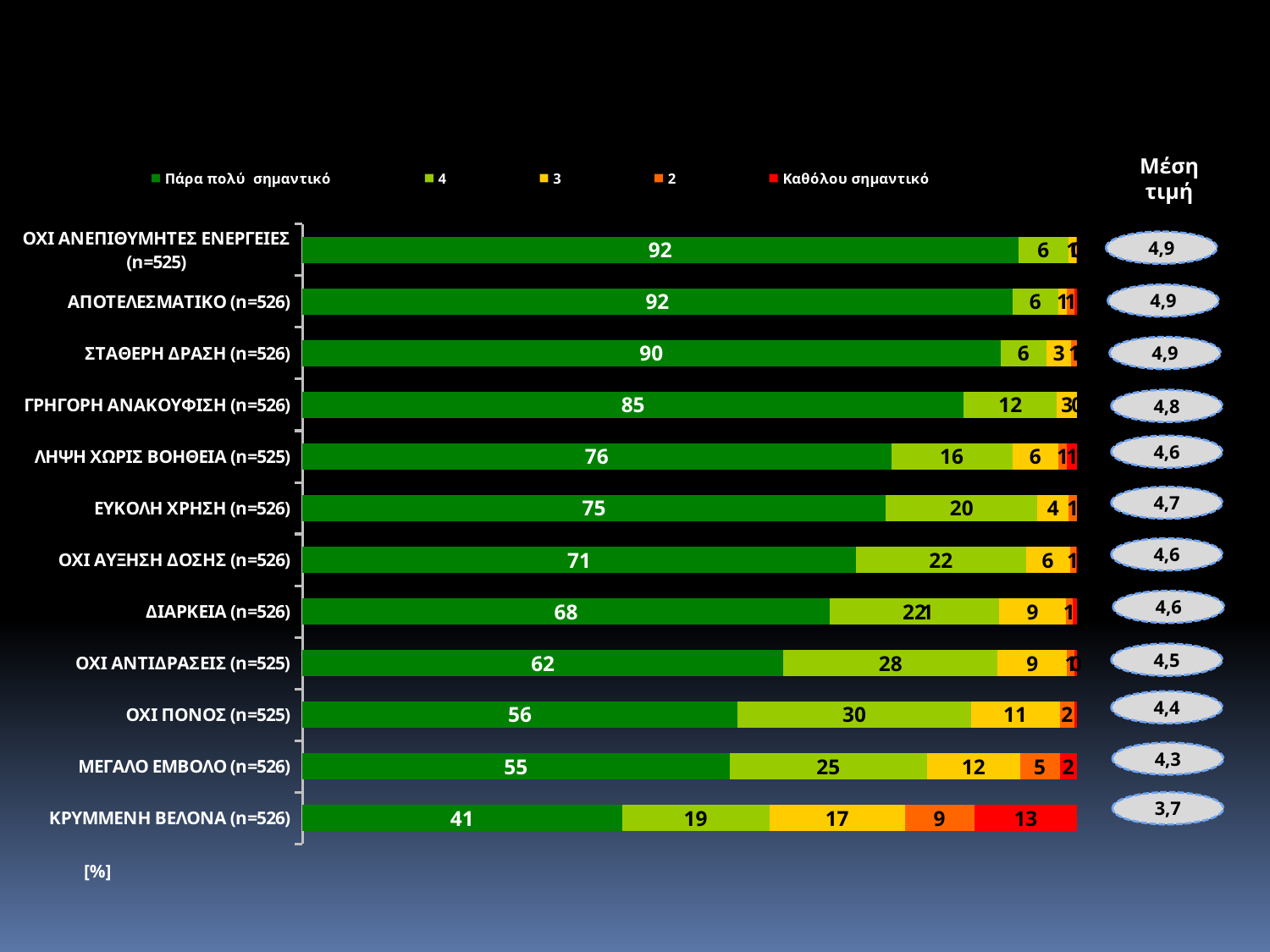
What is the value of 'Πάρα πολύ σημαντικό' for ΓΡΗΓΟΡΗ ΑΝΑΚΟΥΦΙΣΗ (n=526)? 85 Which is larger, the 'Πάρα πολύ σημαντικό' value for ΕΥΚΟΛΗ ΧΡΗΣΗ (n=526) or for ΔΙΑΡΚΕΙΑ (n=526)? ΕΥΚΟΛΗ ΧΡΗΣΗ (n=526) Which category has the highest value for series '4'? ΟΧΙ ΠΟΝΟΣ (n=525) What is the Μέση τιμή shown for ΚΡΥΜΜΕΝΗ ΒΕΛΟΝΑ (n=526)? 3,7 How many categories are shown on the chart? 12 What is the value of series '4' for ΟΧΙ ΠΟΝΟΣ (n=525)? 30 How many series does the legend list? 5 Which category has the lowest value for 'Πάρα πολύ σημαντικό'? ΚΡΥΜΜΕΝΗ ΒΕΛΟΝΑ (n=526) What is the value of 'Πάρα πολύ σημαντικό' for ΚΡΥΜΜΕΝΗ ΒΕΛΟΝΑ (n=526)? 41 What kind of chart is shown on the slide? Stacked bar chart What is the difference between the 'Πάρα πολύ σημαντικό' values for ΣΤΑΘΕΡΗ ΔΡΑΣΗ (n=526) and ΜΕΓΑΛΟ ΕΜΒΟΛΟ (n=526)? 35 What is the value of 'Καθόλου σημαντικό' for ΚΡΥΜΜΕΝΗ ΒΕΛΟΝΑ (n=526)? 13